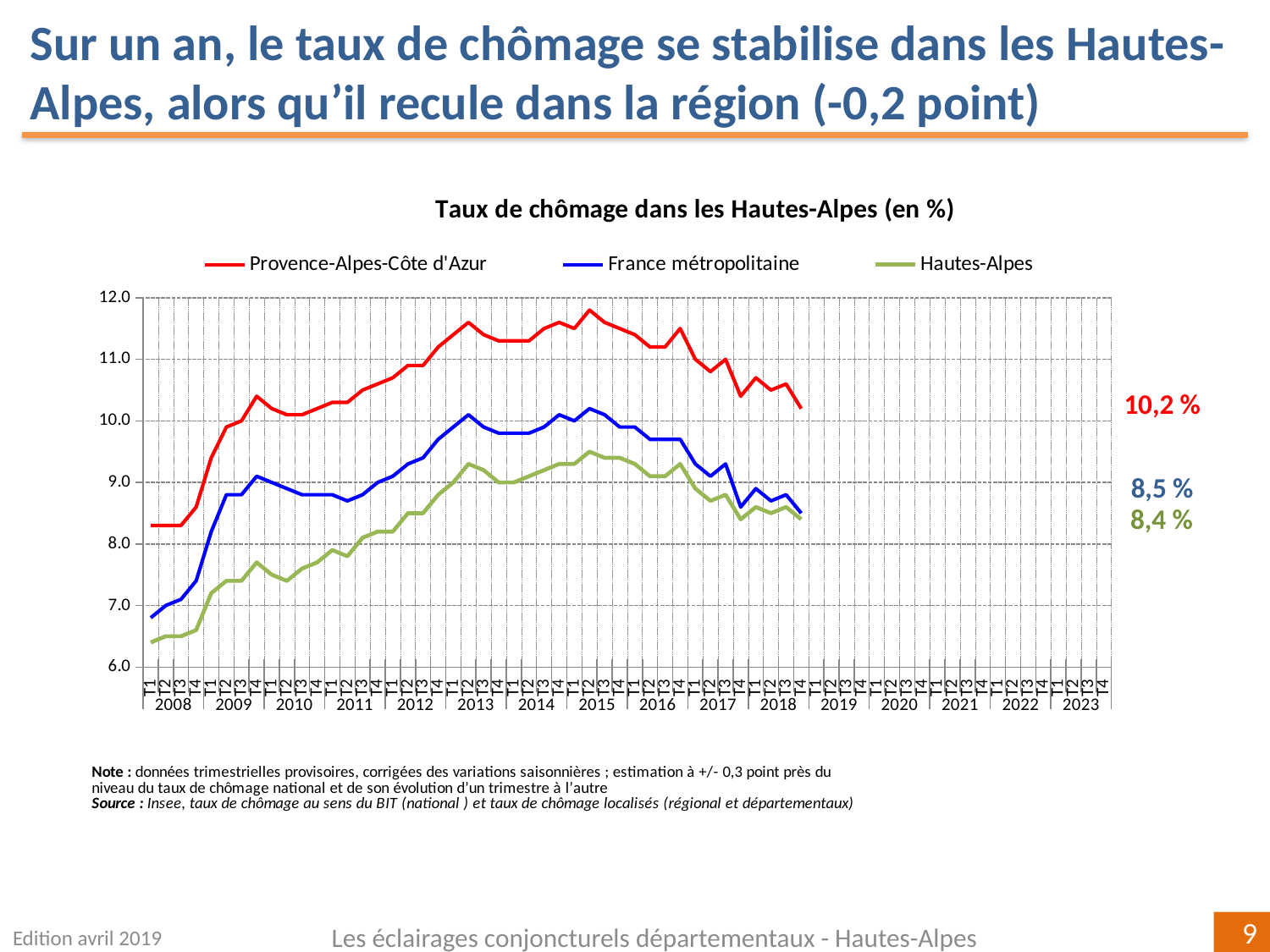
What is the latest unemployment rate shown for Provence-Alpes-Côte d'Azur? 10,2 % Is the value for Provence-Alpes-Côte d'Azur in T2 2015 greater or less than 11.0? greater What is the latest unemployment rate shown for France métropolitaine? 8,5 % What is the difference between the latest labelled values for Provence-Alpes-Côte d'Azur and France métropolitaine? 1,7 points Which series has the highest latest labelled value? Provence-Alpes-Côte d'Azur What is the title of the chart? Taux de chômage dans les Hautes-Alpes (en %) What kind of chart is shown on the slide? line chart Is the value for Hautes-Alpes in T1 2008 greater or less than 7.0? less Which series has the lowest latest labelled value? Hautes-Alpes What is the latest unemployment rate shown for Hautes-Alpes? 8,4 % Does the Hautes-Alpes line rise or fall between 2008 and 2013? rise How many series does the legend list? 3